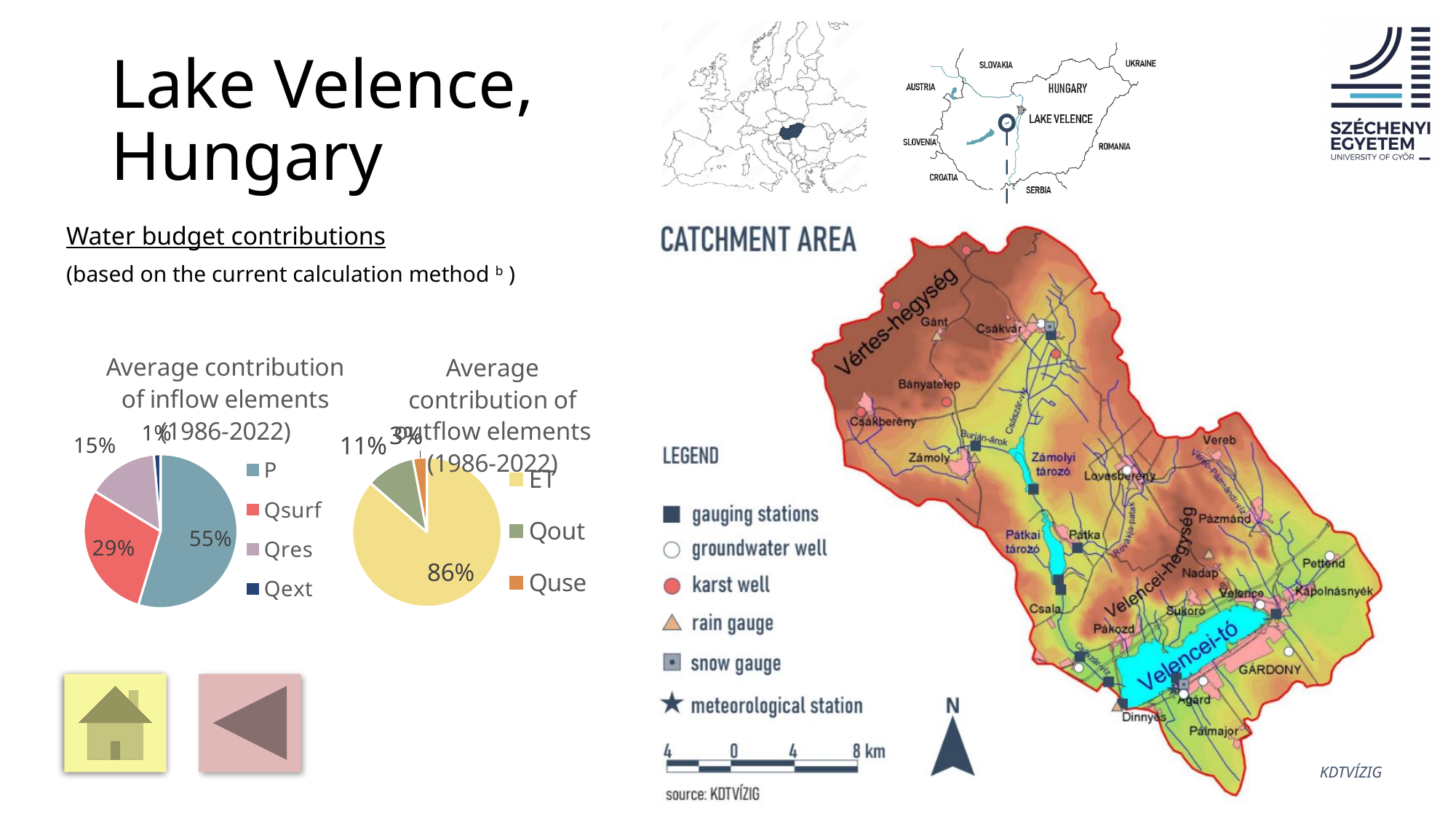
In the 'Average contribution of inflow elements (1986-2022)' chart, how many categories does the legend list? 4 In the 'Average contribution of inflow elements (1986-2022)' chart, which element has the largest share? P In the 'Average contribution of inflow elements (1986-2022)' chart, what share does Qres have? 15% In the 'Average contribution of inflow elements (1986-2022)' chart, which element has the smallest share? Qext In the 'Average contribution of inflow elements (1986-2022)' chart, what share does Qsurf have? 29% In the 'Average contribution of outflow elements (1986-2022)' chart, which element has the smallest share? Quse What type of chart is used for the 'Average contribution of outflow elements (1986-2022)'? Pie chart In the 'Average contribution of outflow elements (1986-2022)' chart, which is larger, Qout or Quse? Qout In the 'Average contribution of outflow elements (1986-2022)' chart, what share does ET have? 86% In the 'Average contribution of outflow elements (1986-2022)' chart, what share does Qout have? 11% In the 'Average contribution of inflow elements (1986-2022)' chart, what share does P have? 55% In the 'Average contribution of inflow elements (1986-2022)' chart, how many percentage points larger is P than Qsurf? 26